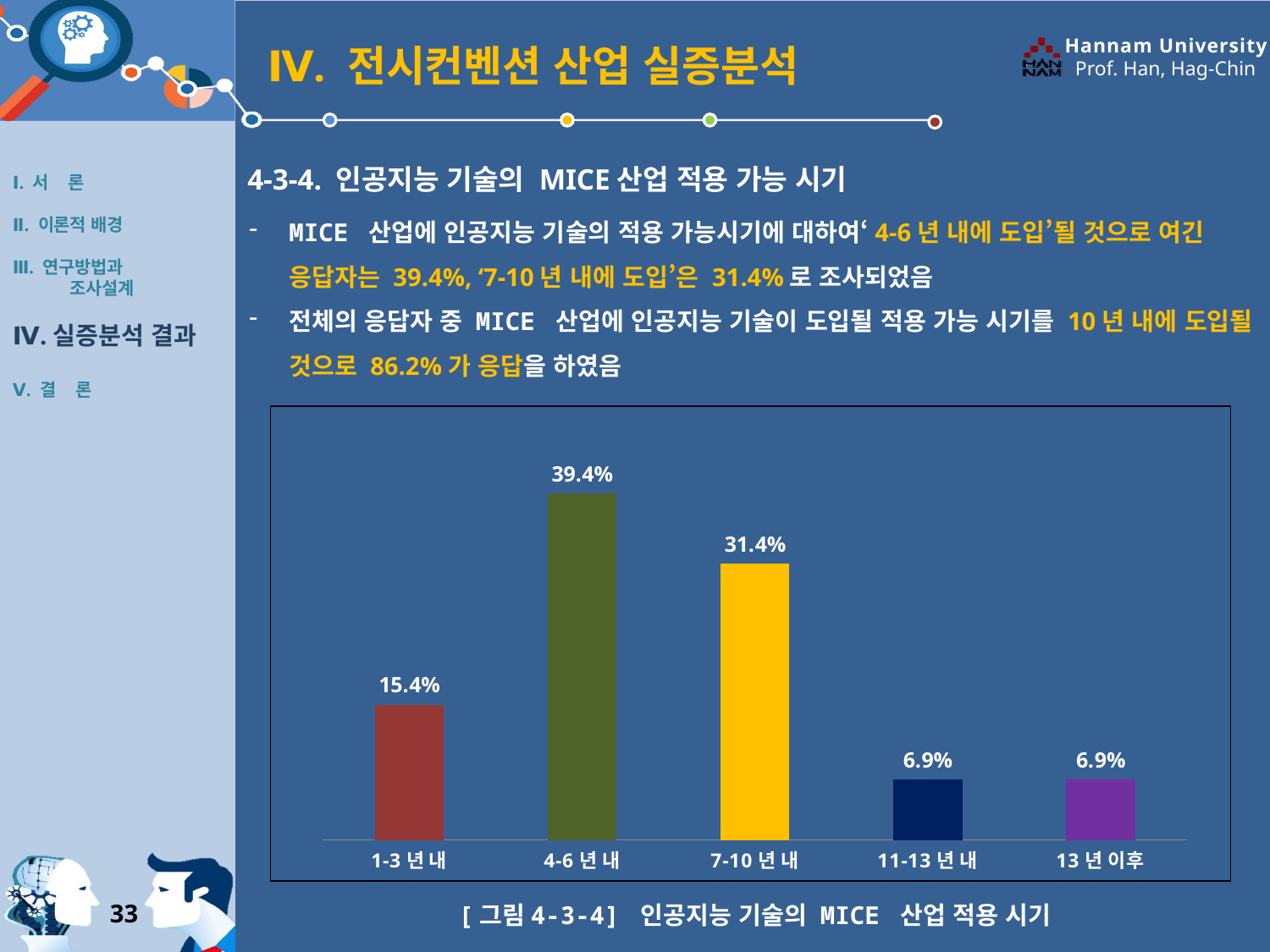
What is the value for the '13 년 이후' category? 6.9% What is the difference between the values for '1-3 년 내' and '11-13 년 내'? 8.5% What is the figure caption shown below the chart? [그림 4-3-4] 인공지능 기술의 MICE 산업 적용 시기 What is the value for the '1-3 년 내' category? 15.4% How many categories are shown in the chart? 5 What is the value for the '7-10 년 내' category? 31.4% What is the lowest value shown in the chart? 6.9% What kind of chart is shown on the slide? Bar chart Which category has the highest value? 4-6 년 내 What is the value for the '4-6 년 내' category? 39.4% Which is larger, the value for '1-3 년 내' or the value for '7-10 년 내'? 7-10 년 내 What is the difference between the values for '4-6 년 내' and '7-10 년 내'? 8.0%